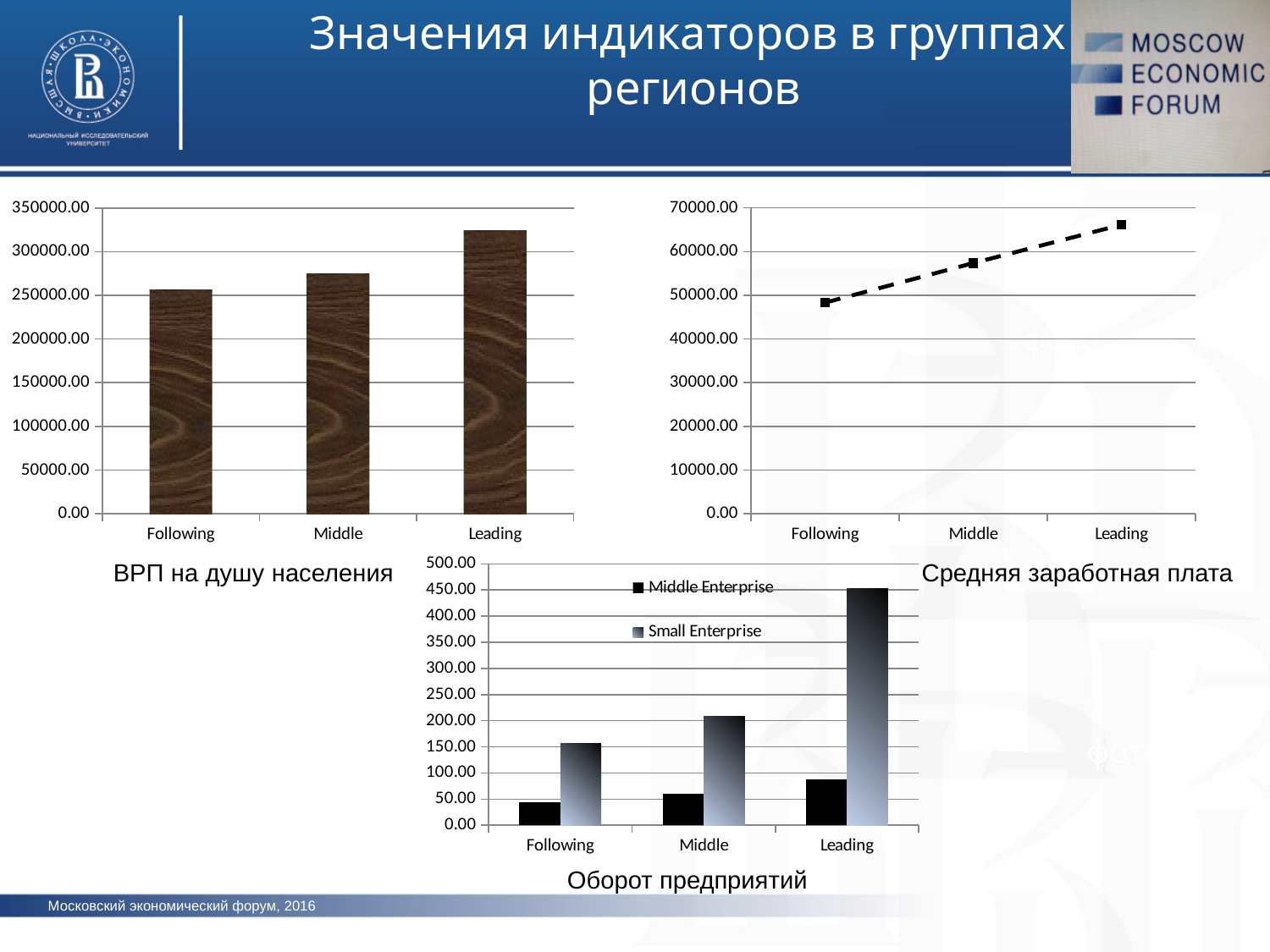
In the chart titled 'ВРП на душу населения', which category has the highest value? Leading In the chart titled 'Оборот предприятий', which is larger for Leading: Middle Enterprise or Small Enterprise? Small Enterprise What kind of chart is the one titled 'ВРП на душу населения'? bar chart What kind of chart is the one titled 'Средняя заработная плата'? line chart In the chart titled 'Средняя заработная плата', is the value for Leading greater or less than 60000.00? greater In the chart titled 'ВРП на душу населения', is the value for Leading greater or less than 300000.00? greater In the chart titled 'Средняя заработная плата', do the values rise or fall from Following to Leading? rise How many series does the legend list in the chart titled 'Оборот предприятий'? 2 In the chart titled 'ВРП на душу населения', which category has the lowest value? Following In the chart titled 'Средняя заработная плата', is the value for Following greater or less than 50000.00? less